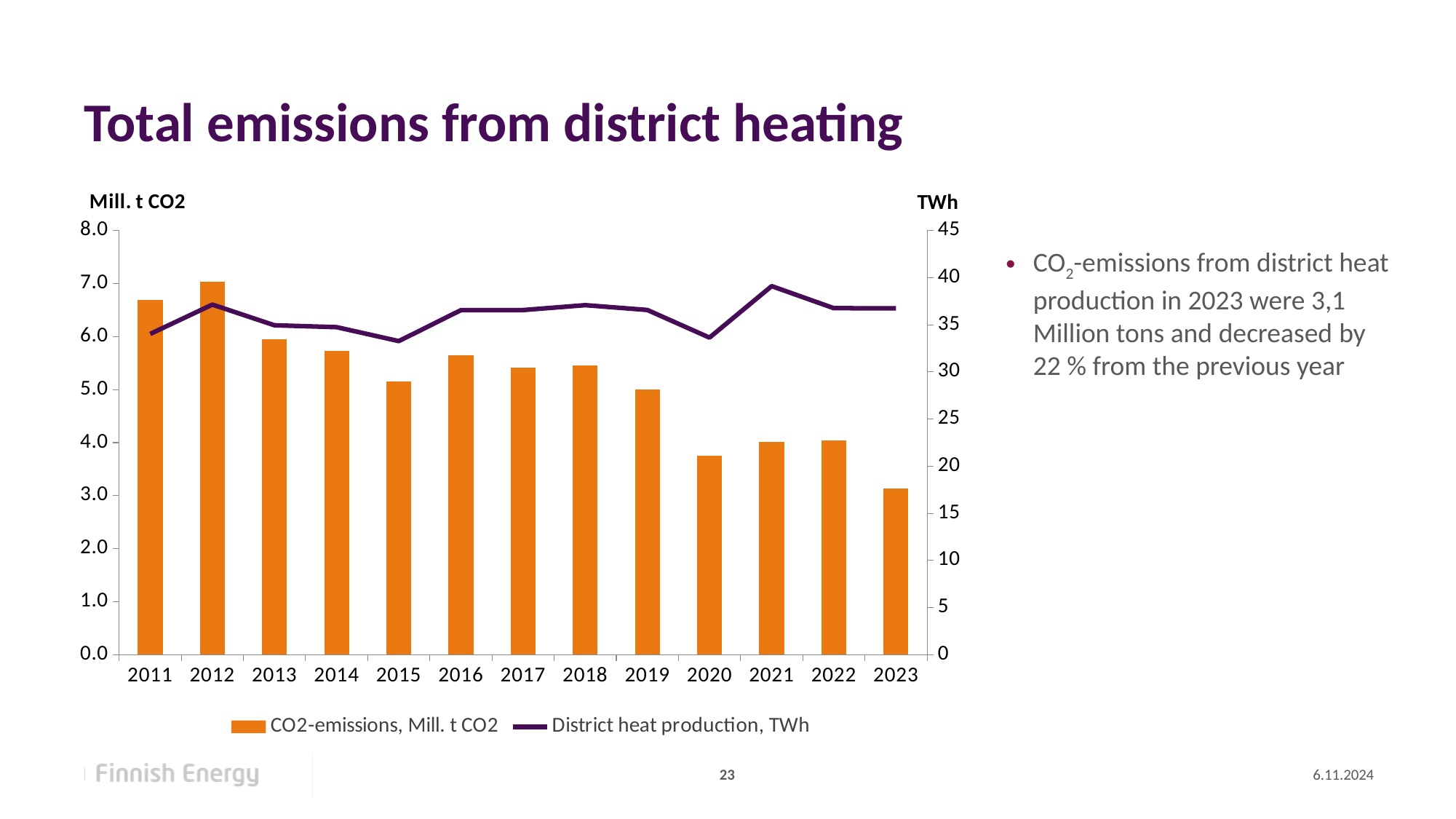
Which year has the highest CO2-emissions bar? 2012 Do the CO2-emissions bars generally rise or fall from 2011 to 2023? Fall How many years are shown on the x axis of the chart? 13 Is the District heat production value for 2021 greater or less than 35 TWh? greater Is the CO2-emissions value for 2016 greater or less than 5.0 Mill. t CO2? greater Which year has the lowest CO2-emissions bar? 2023 What kind of chart is used for the CO2-emissions series? Bar chart How many series does the legend list? 2 Is the CO2-emissions value for 2011 greater or less than 6.0 Mill. t CO2? greater In which year does the District heat production line reach its highest point? 2021 Which year has higher CO2-emissions, 2019 or 2020? 2019